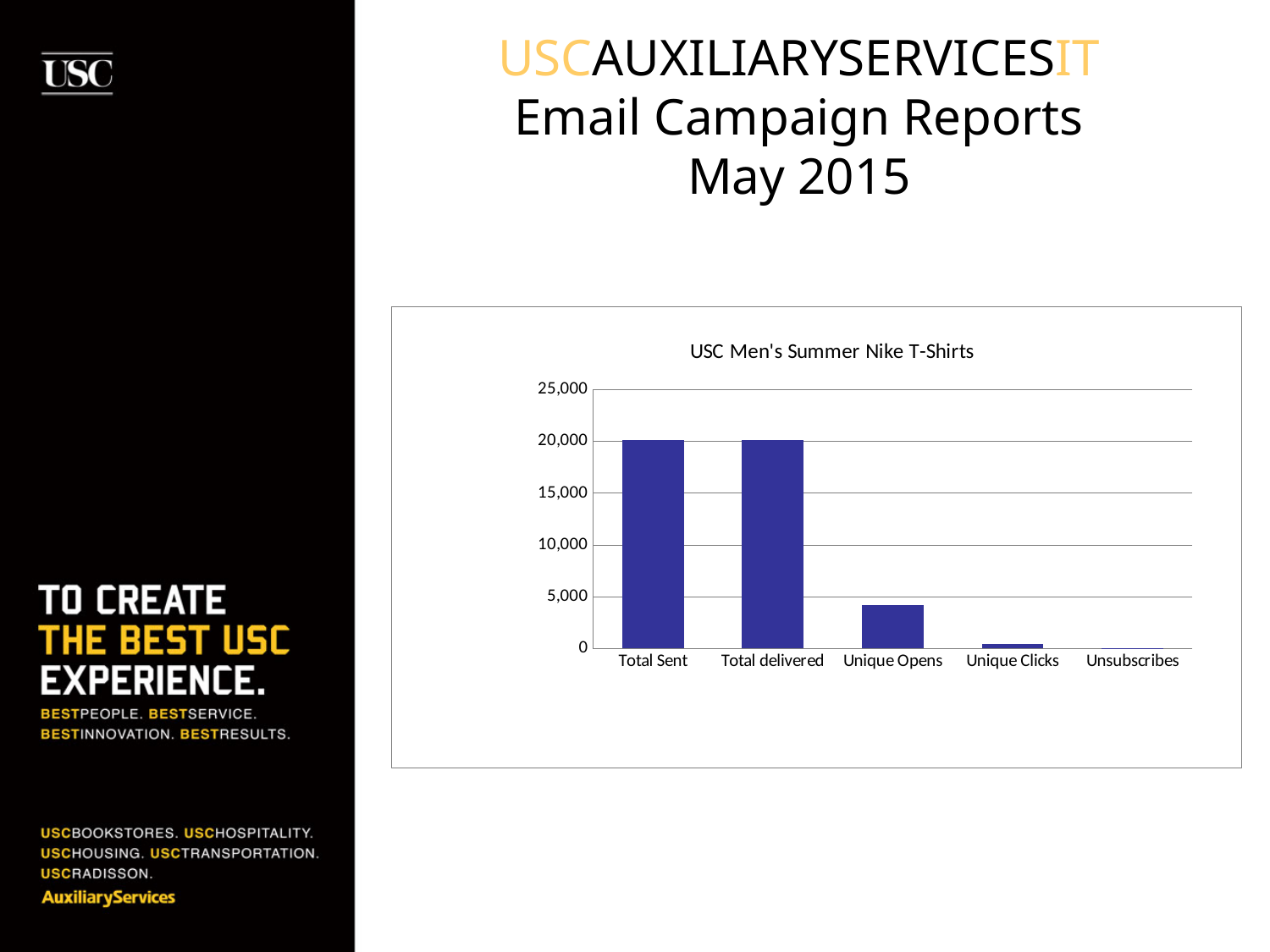
Is the value for Unique Clicks greater or less than 5,000? less What kind of chart is shown on the slide? bar chart What is the title of the chart? USC Men's Summer Nike T-Shirts Is the value for Unique Opens greater or less than 10,000? less How many categories are shown on the x axis of the chart? 5 Do the values generally rise or fall moving from left to right along the x axis? fall Which is larger, the value for Unique Opens or the value for Unique Clicks? Unique Opens Is the value for Unique Opens greater or less than 5,000? less Which is larger, the value for Total Sent or the value for Unique Opens? Total Sent Which category has the lowest value in the chart? Unsubscribes